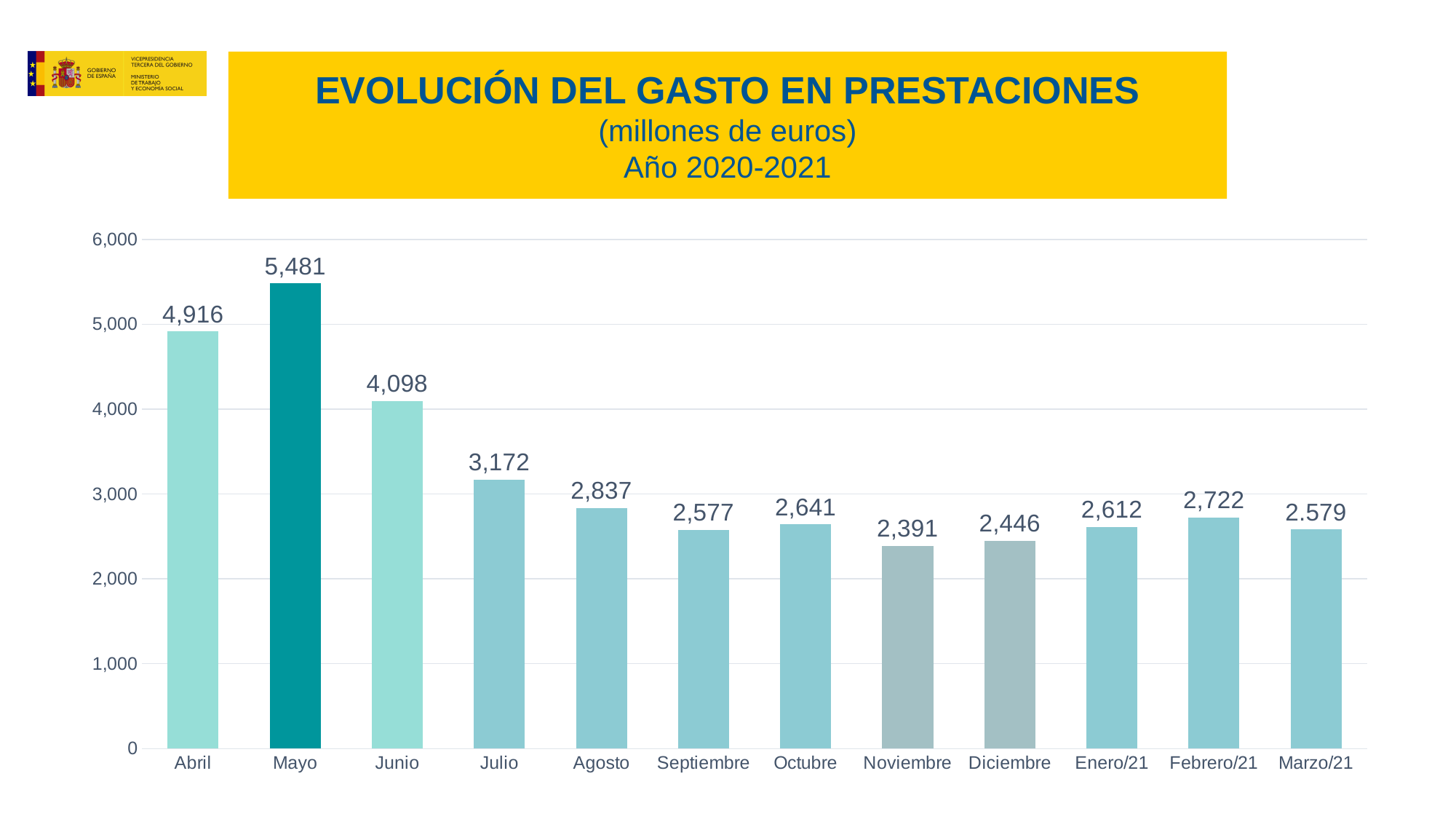
What kind of chart is shown on the slide? bar chart Is the value for Julio greater or less than 3,000? greater Which month has the lowest value? Noviembre What is the value for Noviembre? 2,391 What unit is stated in the chart title? millones de euros What is the difference between the values for Mayo and Junio? 1,383 Which month has the highest value? Mayo Which is larger, the value for Octubre or the value for Septiembre? Octubre What is the value for Mayo? 5,481 Do the values generally rise or fall from Abril to Noviembre? fall What is the value for Febrero/21? 2,722 How many months are shown on the x axis? 12